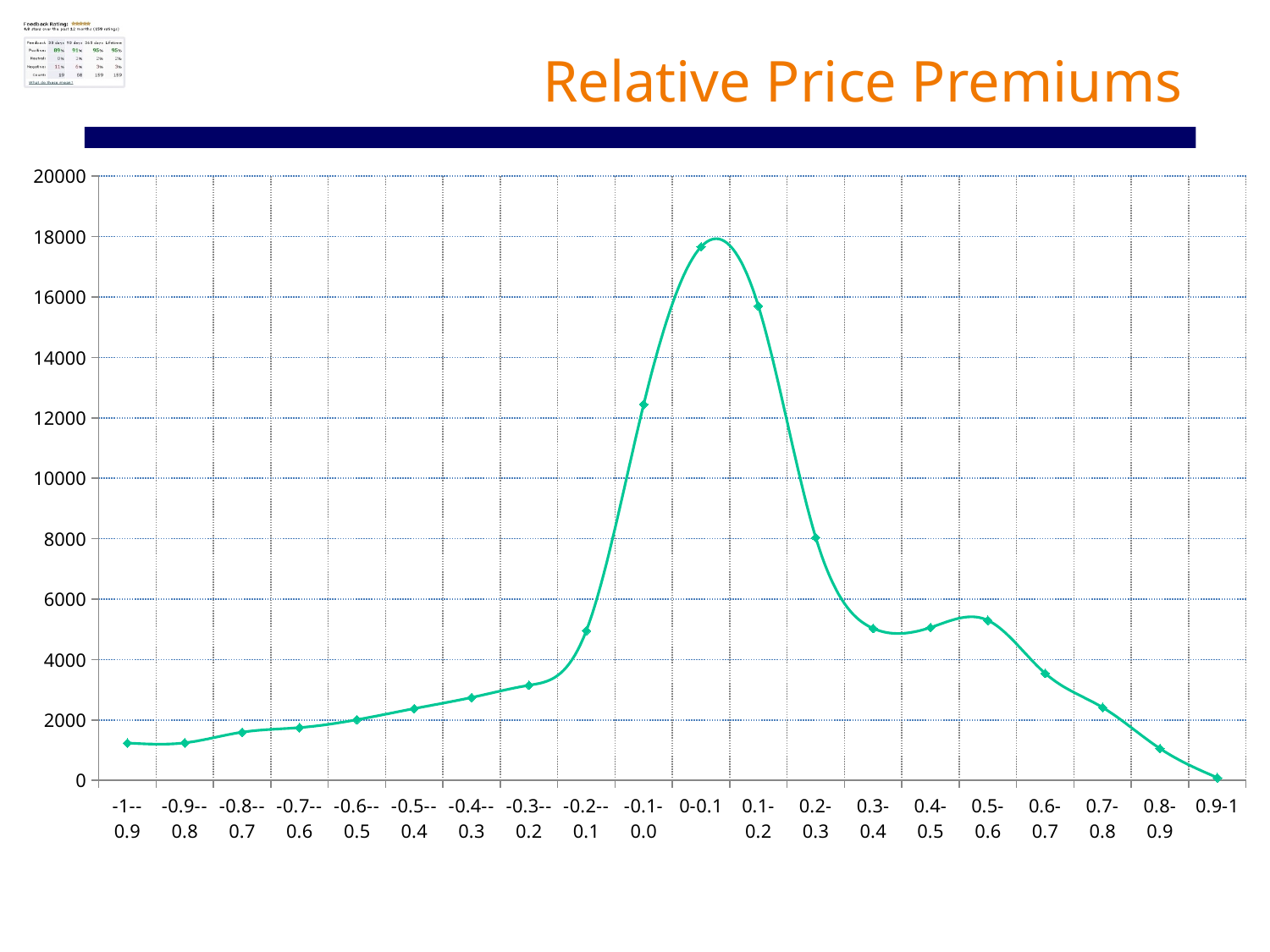
Is the value for -0.2--0.1 greater or less than 6000? less Is the value for -1--0.9 greater or less than 2000? less What is the title of the chart? Relative Price Premiums Which category has the highest value? 0-0.1 Which is larger, the value for 0-0.1 or the value for 0.1-0.2? 0-0.1 Is the value for 0-0.1 greater or less than 16000? greater How many categories are shown on the x axis? 20 Which is larger, the value for 0.2-0.3 or the value for 0.5-0.6? 0.2-0.3 Do the values generally rise or fall from 0-0.1 to 0.9-1? fall Which category has the lowest value? 0.9-1 What kind of chart is shown on the slide? line chart